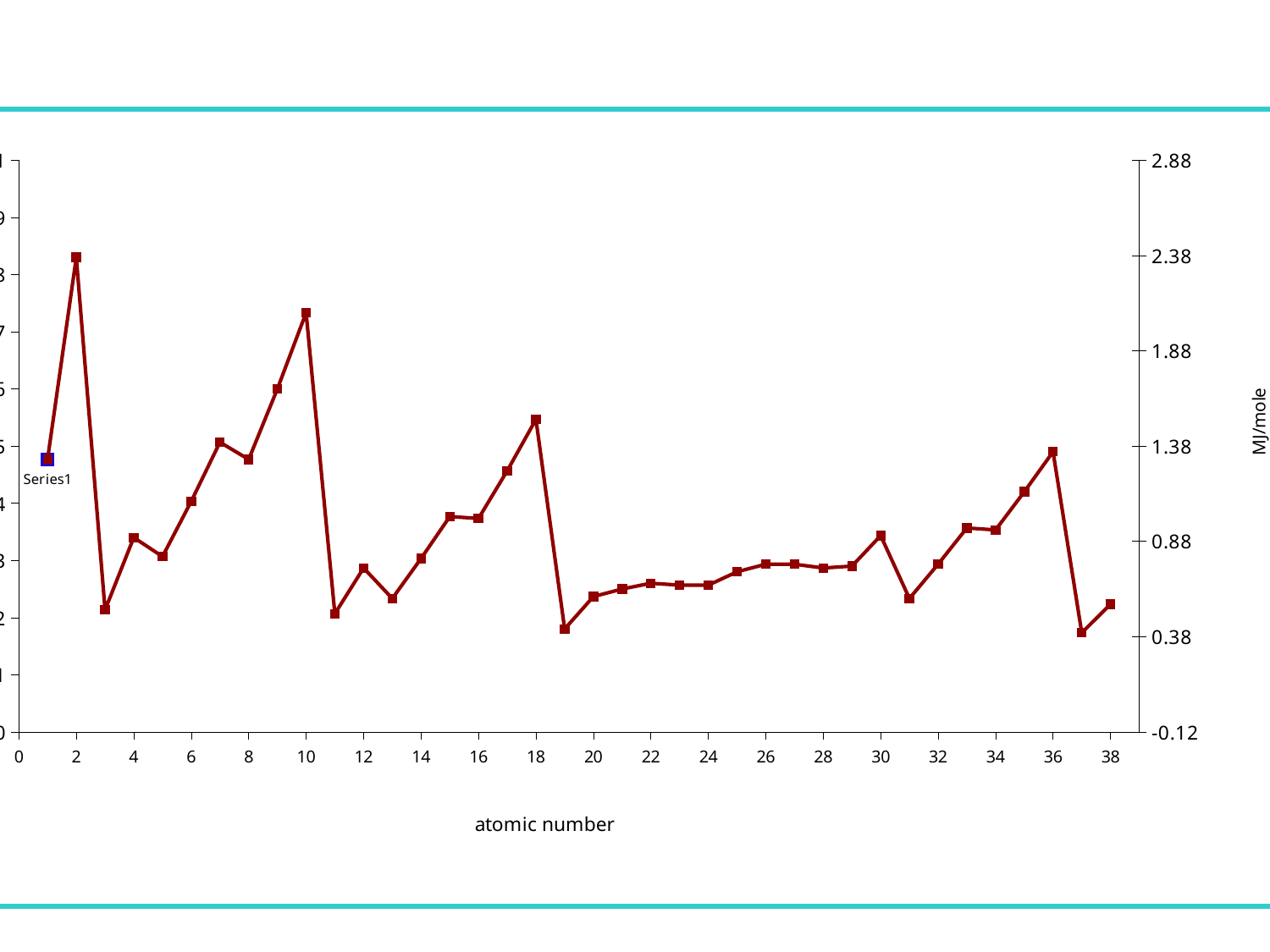
What is the title of the right-hand y axis? MJ/mole What kind of chart is shown on the slide? line chart Is the value at atomic number 3 greater or less than 0.88 MJ/mole? less Is the value at atomic number 2 greater or less than 1.88 MJ/mole? greater Which has the larger value, atomic number 18 or atomic number 36? atomic number 18 Is the value at atomic number 19 greater or less than 0.88 MJ/mole? less Does the line rise or fall between atomic number 11 and atomic number 18? rise What is the title of the x axis? atomic number At which atomic number does the line reach its highest value? 2 Which has the larger value, atomic number 2 or atomic number 10? atomic number 2